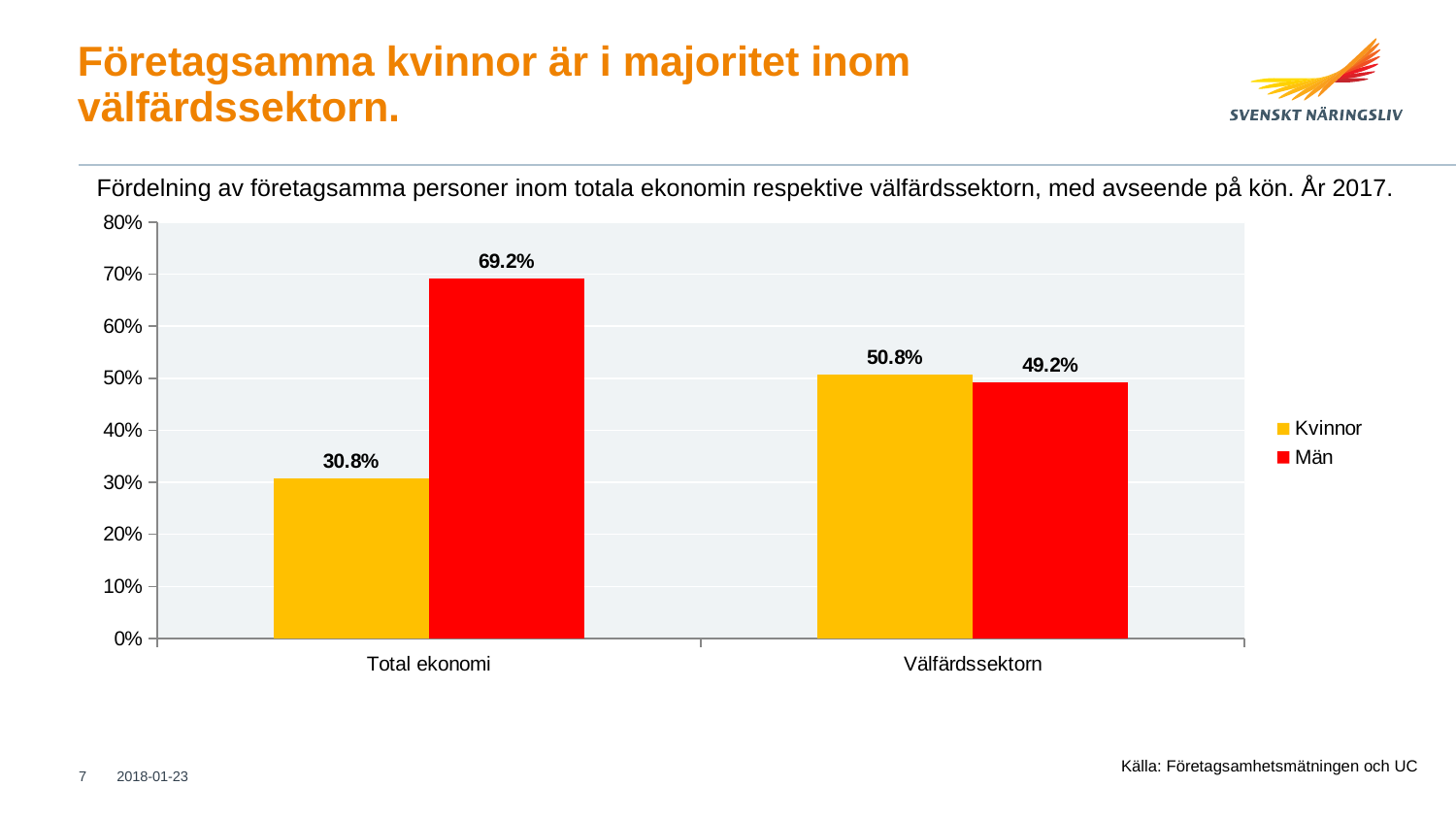
What is the value for Kvinnor in Välfärdssektorn? 50.8% What is the value for Män in Total ekonomi? 69.2% How many categories are shown on the x axis? 2 What is the value for Kvinnor in Total ekonomi? 30.8% Which category has the highest value for Män? Total ekonomi What kind of chart is shown on the slide? Bar chart What is the difference between Kvinnor in Välfärdssektorn and Kvinnor in Total ekonomi? 20.0% Which category has the lowest value for Kvinnor? Total ekonomi What is the value for Män in Välfärdssektorn? 49.2% What is the difference between Män and Kvinnor in Total ekonomi? 38.4% How many series does the legend list? 2 Which is larger in Total ekonomi, Kvinnor or Män? Män